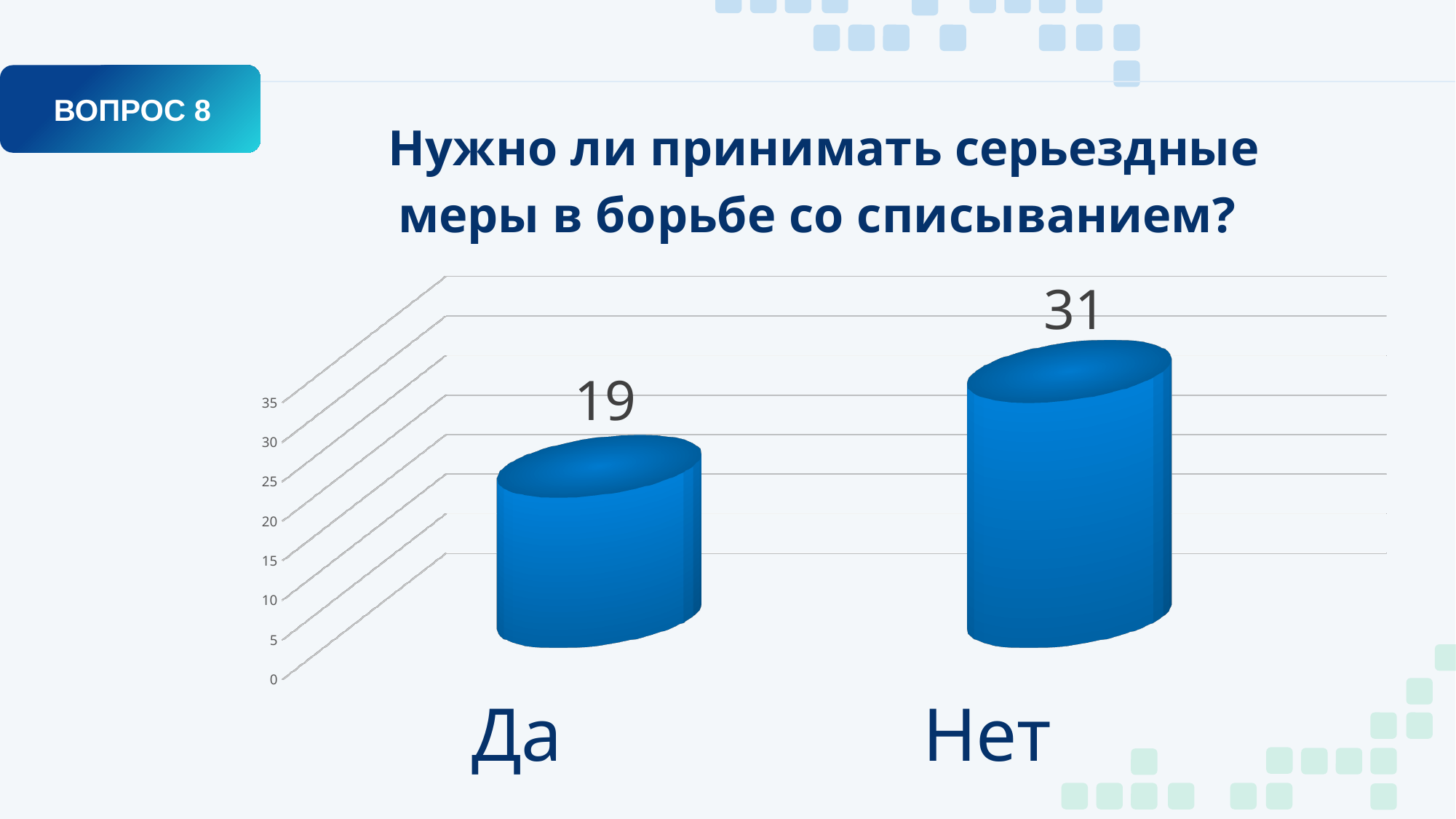
What is the value for "Нет"? 31 Which category has the highest value? Нет What is the value for "Да"? 19 What kind of chart is shown on the slide? bar chart Which is larger, the value for "Да" or the value for "Нет"? Нет Which category has the lowest value? Да What is the total of the two values shown in the chart? 50 Is the value for "Да" greater or less than 20? less What is the difference between the values for "Нет" and "Да"? 12 Is the value for "Нет" greater or less than 30? greater What is the title of the chart? Нужно ли принимать серьездные меры в борьбе со списыванием? How many categories are shown in the chart? 2